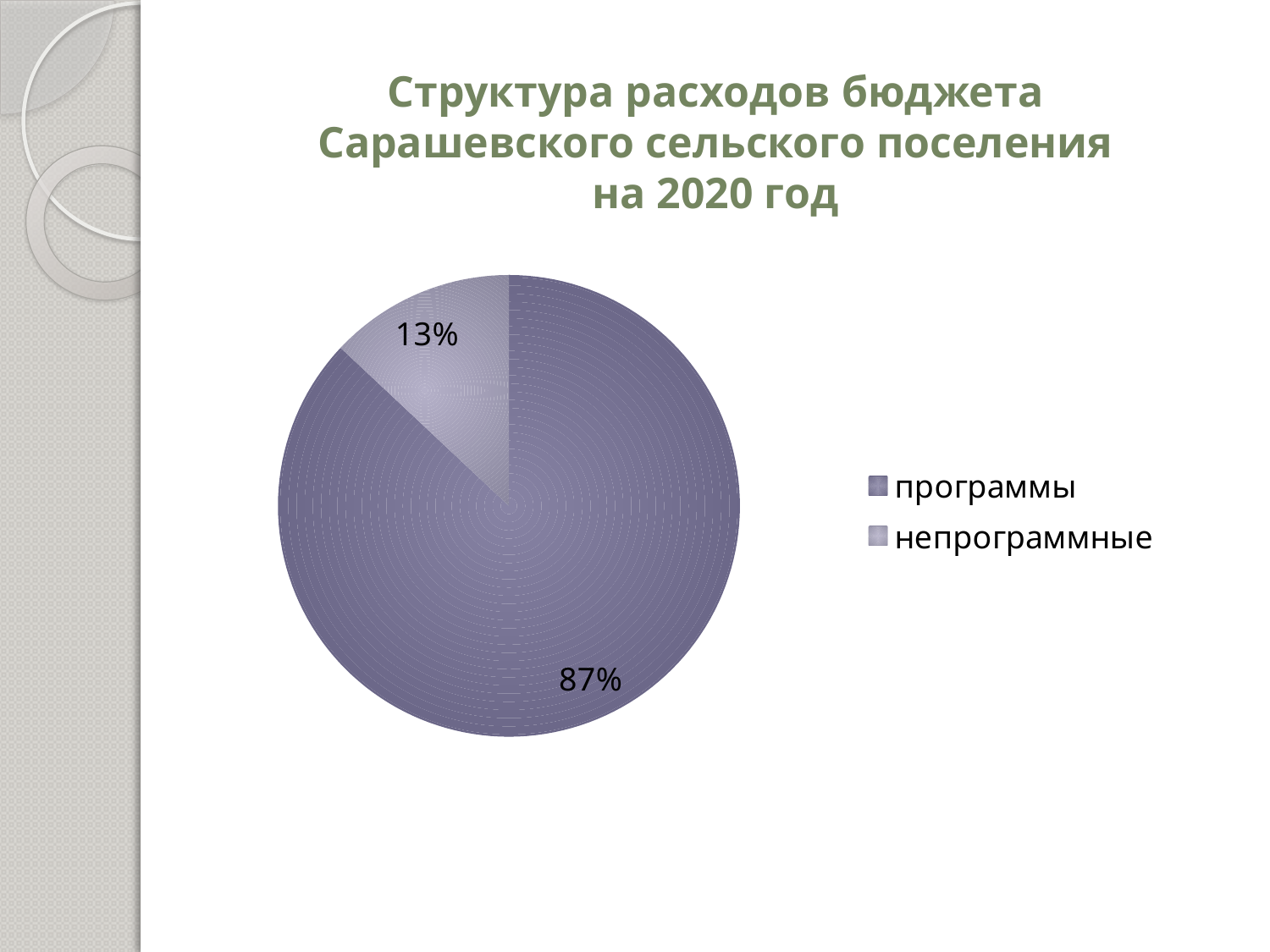
Which category has the smallest slice of the pie? непрограммные How many entries does the legend list? 2 Which legend entry is listed first? программы Which category has the largest slice of the pie? программы What is the difference in percentage points between the 'программы' and 'непрограммные' slices? 74 What kind of chart is shown on the slide? pie chart What share of the pie does the 'непрограммные' slice represent? 13% Which is larger, the 'программы' slice or the 'непрограммные' slice? программы What is the title of the chart on the slide? Структура расходов бюджета Сарашевского сельского поселения на 2020 год How many categories are shown in the pie chart? 2 What share of the pie does the 'программы' slice represent? 87%